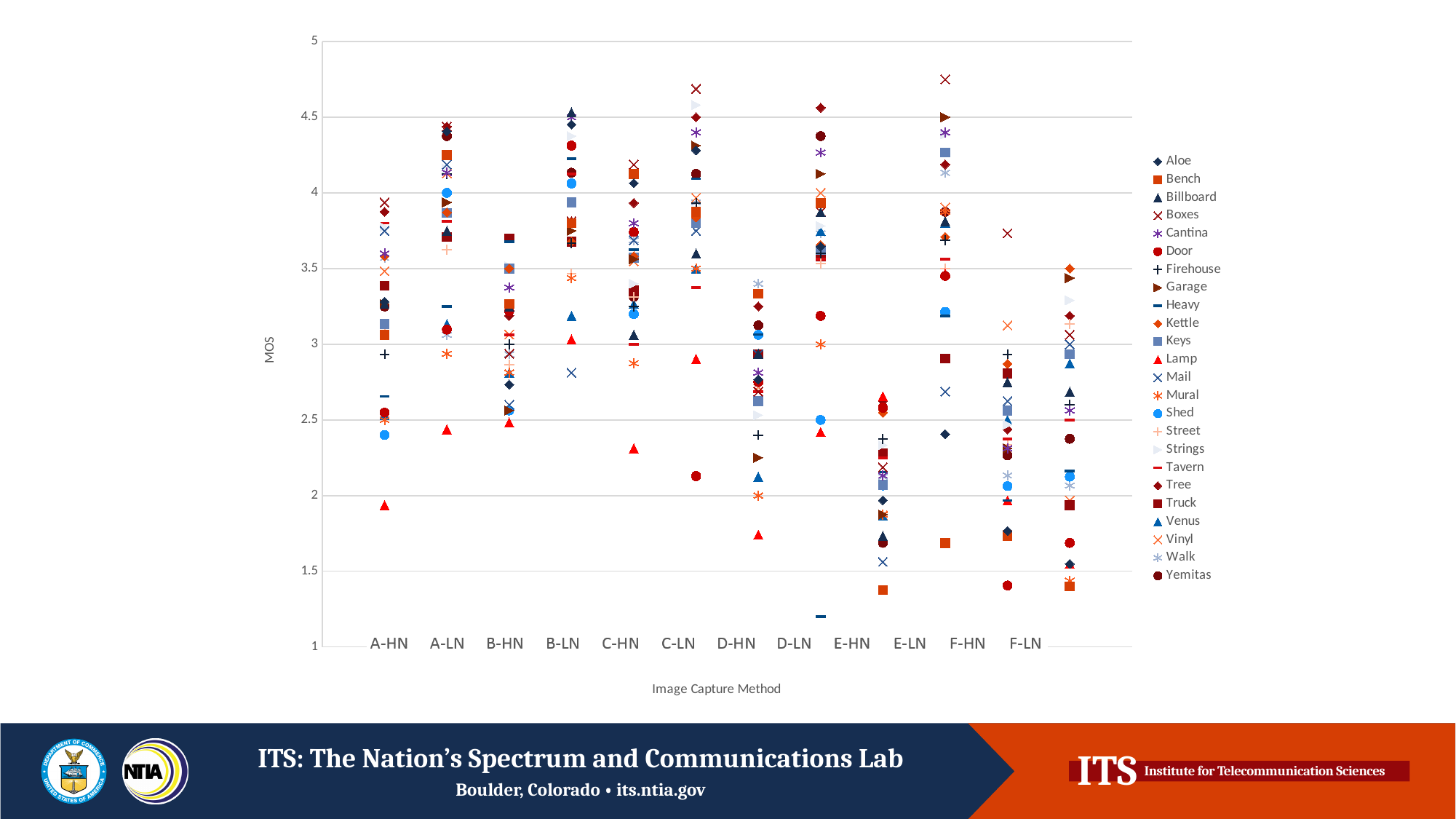
Is the value for Boxes at F-HN greater or less than 4.5? less Which is larger, the value for Lamp at A-HN or the value for Lamp at A-LN? A-LN What is the label of the y axis? MOS How many image capture method categories are shown on the x axis? 12 What is the label of the x axis? Image Capture Method Is the value for Lamp at A-HN greater or less than 2? less How many series does the legend list? 24 What kind of chart is shown on the slide? scatter chart Is the value for Heavy at E-HN greater or less than 1.5? greater Which series has the highest value at F-HN? Boxes Which series has the lowest value at E-HN? Bench